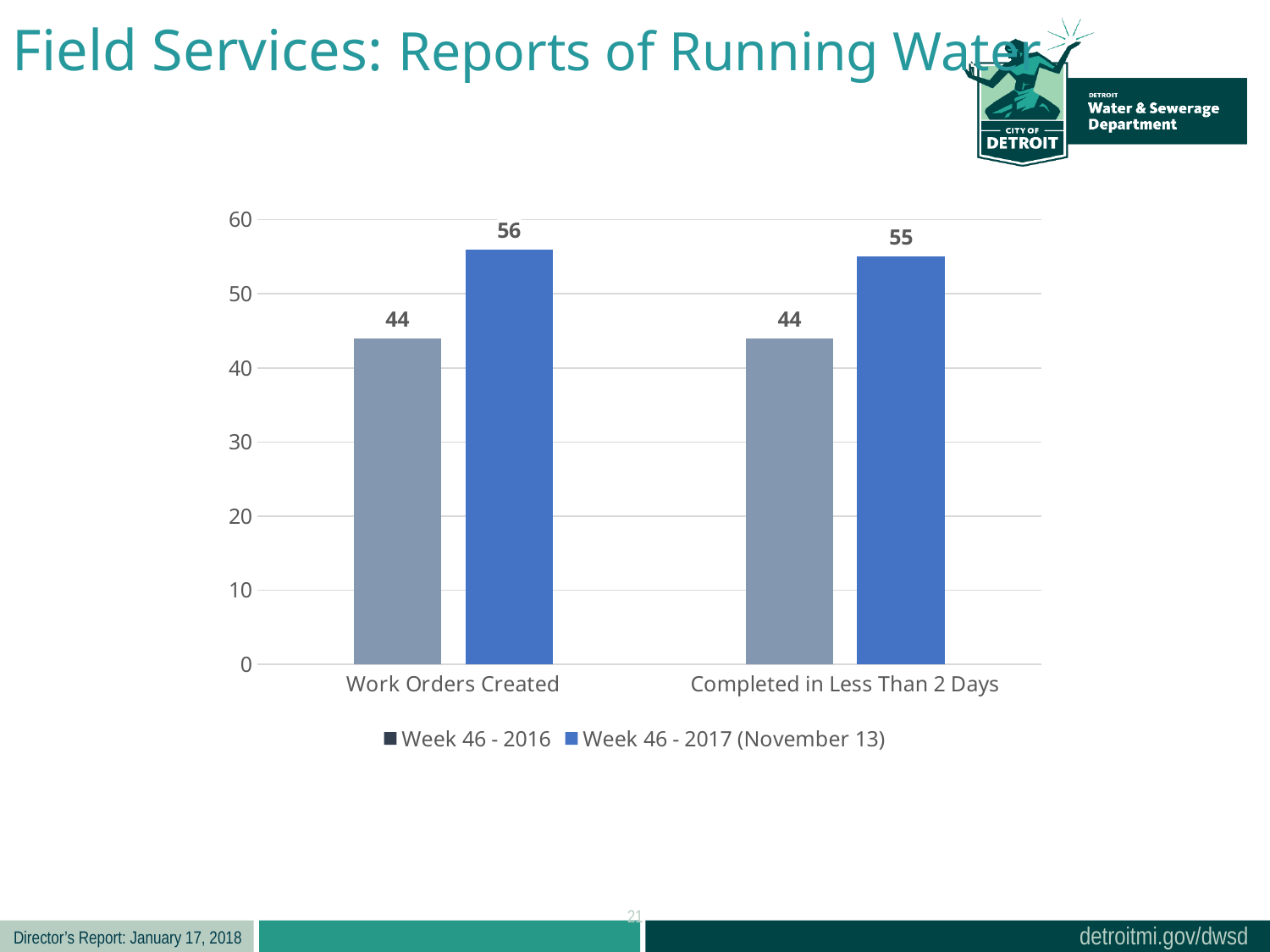
Which bar is the highest on the chart? Work Orders Created, Week 46 - 2017 (November 13) What is the value for Work Orders Created in Week 46 - 2017 (November 13)? 56 What is the difference between Completed in Less Than 2 Days in Week 46 - 2017 (November 13) and Week 46 - 2016? 11 Which series has the larger value for Work Orders Created, Week 46 - 2016 or Week 46 - 2017 (November 13)? Week 46 - 2017 (November 13) How many series does the legend list? 2 What is the value for Completed in Less Than 2 Days in Week 46 - 2016? 44 Is the value for Work Orders Created in Week 46 - 2016 greater or less than 50? less What is the difference between Work Orders Created in Week 46 - 2017 (November 13) and Week 46 - 2016? 12 What kind of chart is shown on the slide? bar chart How many categories are shown on the x axis? 2 What is the value for Completed in Less Than 2 Days in Week 46 - 2017 (November 13)? 55 What is the value for Work Orders Created in Week 46 - 2016? 44